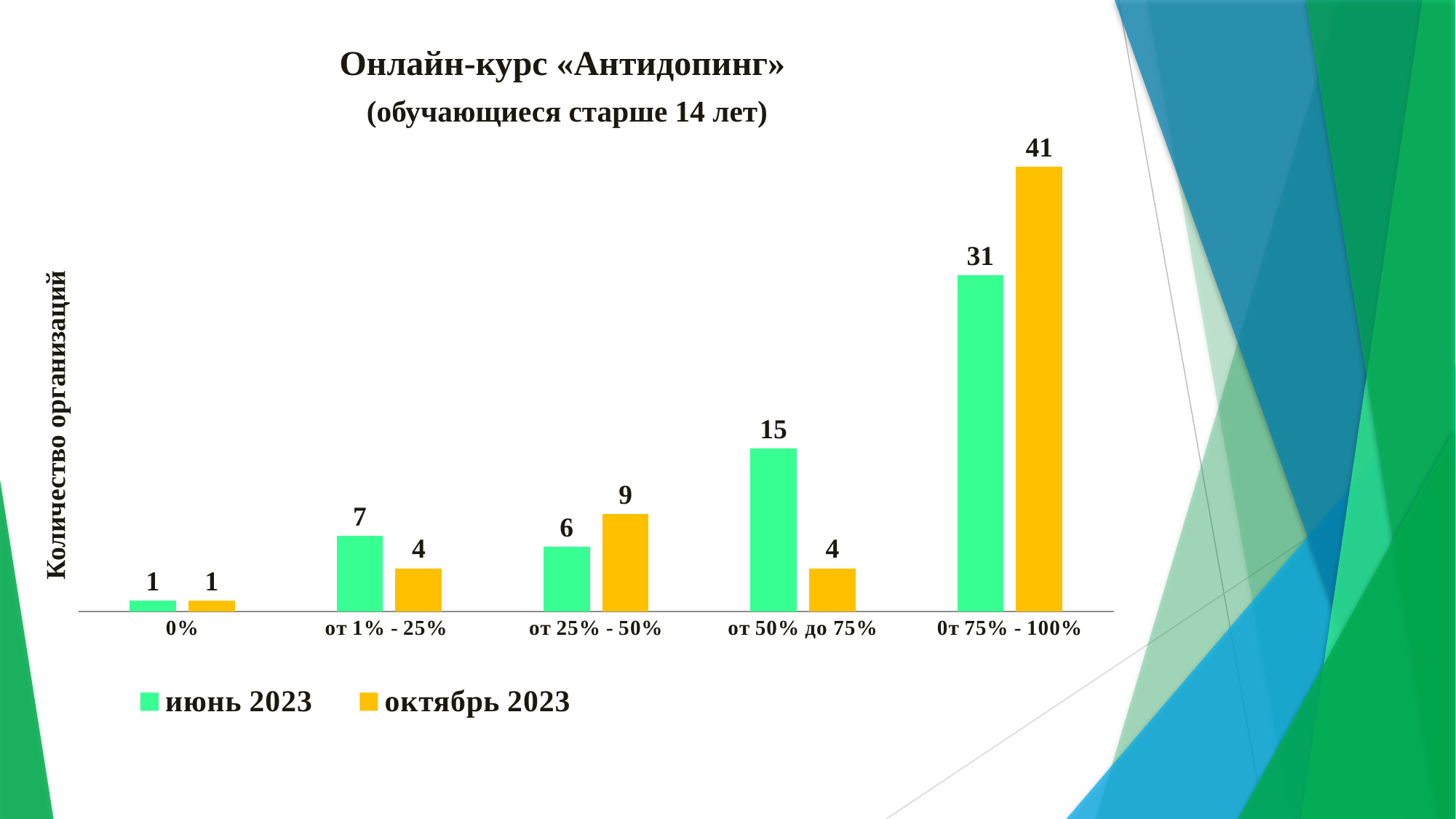
What is the value for июнь 2023 in the category от 50% до 75%? 15 What is the value for октябрь 2023 in the category от 75% - 100%? 41 Which category has the highest value for июнь 2023? от 75% - 100% What is the value for октябрь 2023 in the category от 1% - 25%? 4 What kind of chart is shown on the slide? bar chart What is the difference between октябрь 2023 and июнь 2023 in the category от 75% - 100%? 10 How many categories are shown on the x axis? 5 What is the difference between июнь 2023 and октябрь 2023 in the category от 50% до 75%? 11 In the category от 25% - 50%, which series has the larger value, июнь 2023 or октябрь 2023? октябрь 2023 What is the label of the vertical axis? Количество организаций How many series does the legend list? 2 Which category has the lowest value for октябрь 2023? 0%